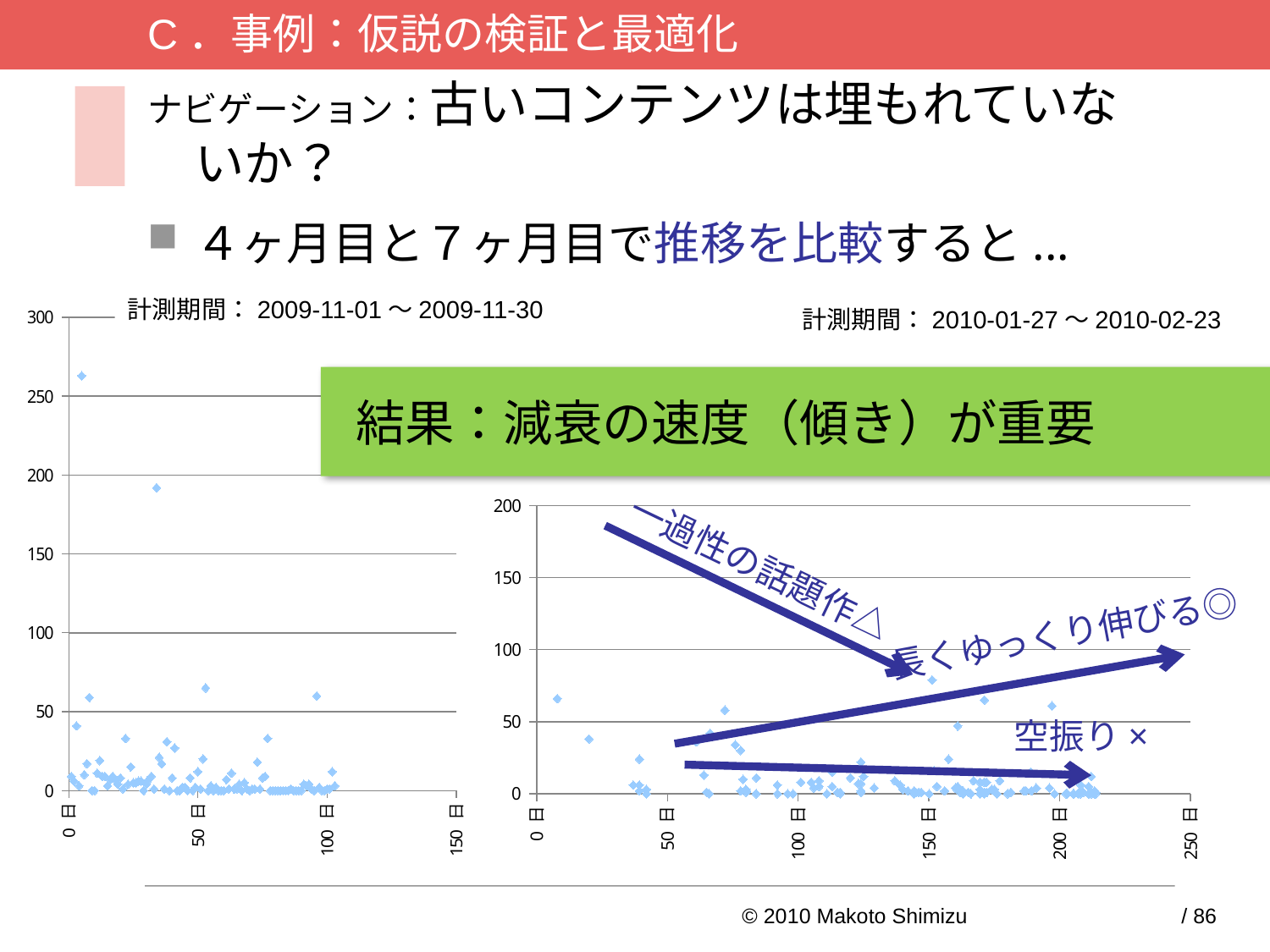
On the right chart, what is the highest value shown on the vertical axis? 200 On the left chart, is the highest plotted point greater or less than 250? greater Do the plotted values on the left chart generally rise or fall as the horizontal axis increases? fall On the right chart, what is the largest value labelled on the horizontal axis? 250 How many charts are shown on the slide? 2 What kind of chart is the chart on the left of the slide? scatter chart On the right chart, is the highest plotted point greater or less than 50? greater On the right chart, is the highest plotted point greater or less than 100? less On the left chart, what is the largest value labelled on the horizontal axis? 150 What kind of chart is the chart on the right of the slide? scatter chart Which chart has the higher maximum plotted value, the left chart or the right chart? the left chart